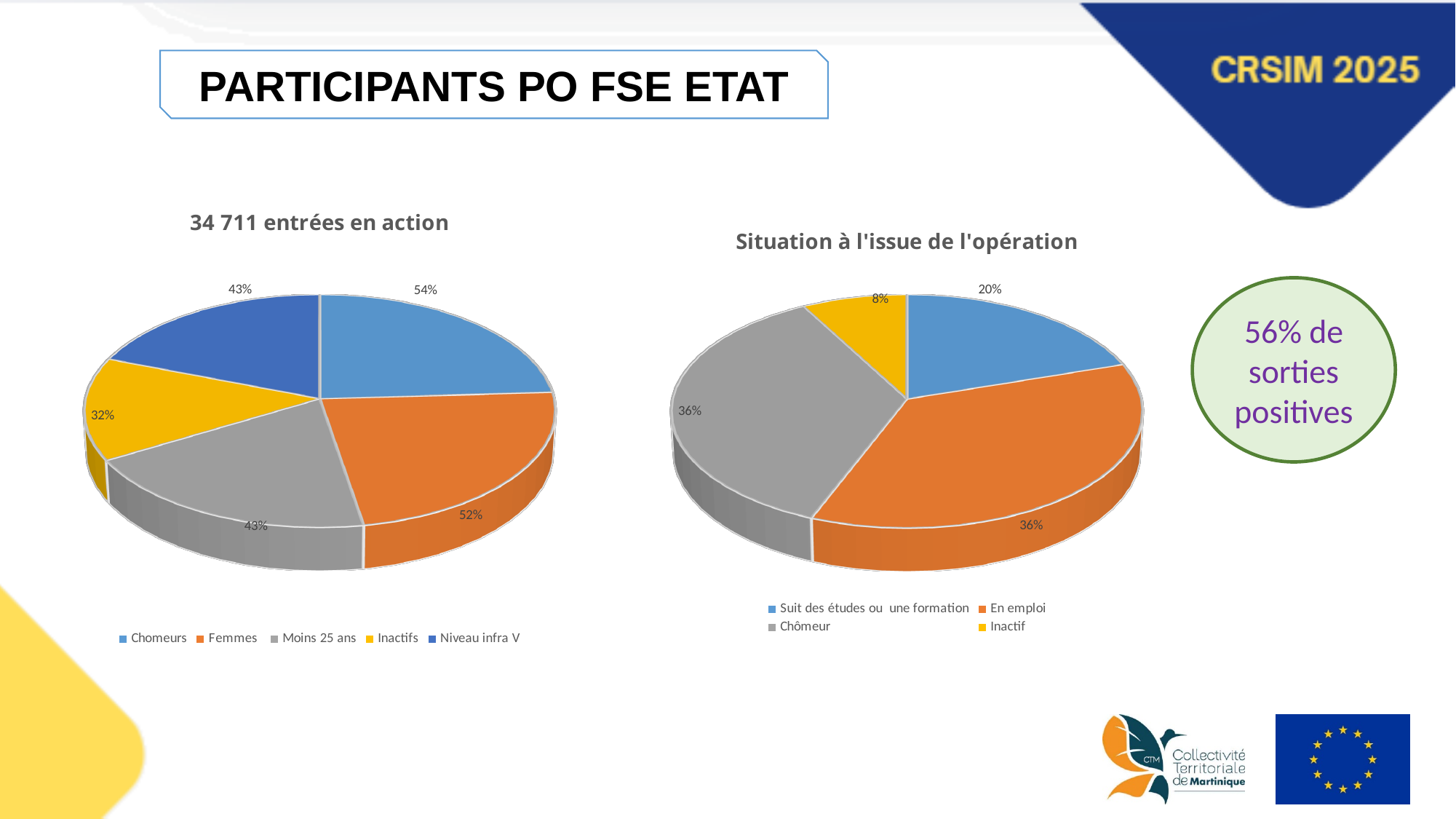
In the pie chart titled 'Situation à l'issue de l'opération', what is the difference in percentage points between En emploi and Inactif? 28 In the pie chart titled '34 711 entrées en action', what percentage is shown for Chomeurs? 54% In the pie chart titled 'Situation à l'issue de l'opération', what percentage is shown for Suit des études ou une formation? 20% In the pie chart titled 'Situation à l'issue de l'opération', what percentage is shown for En emploi? 36% In the pie chart titled '34 711 entrées en action', what percentage is shown for Inactifs? 32% How many categories does the legend of the pie chart titled '34 711 entrées en action' list? 5 In the pie chart titled 'Situation à l'issue de l'opération', which is larger: Chômeur or Inactif? Chômeur In the pie chart titled '34 711 entrées en action', which category has the largest share? Chomeurs What type of chart is used for 'Situation à l'issue de l'opération'? Pie chart In the pie chart titled '34 711 entrées en action', which category has the smallest share? Inactifs In the pie chart titled '34 711 entrées en action', what is the difference in percentage points between Chomeurs and Inactifs? 22 In the pie chart titled 'Situation à l'issue de l'opération', which category has the smallest share? Inactif